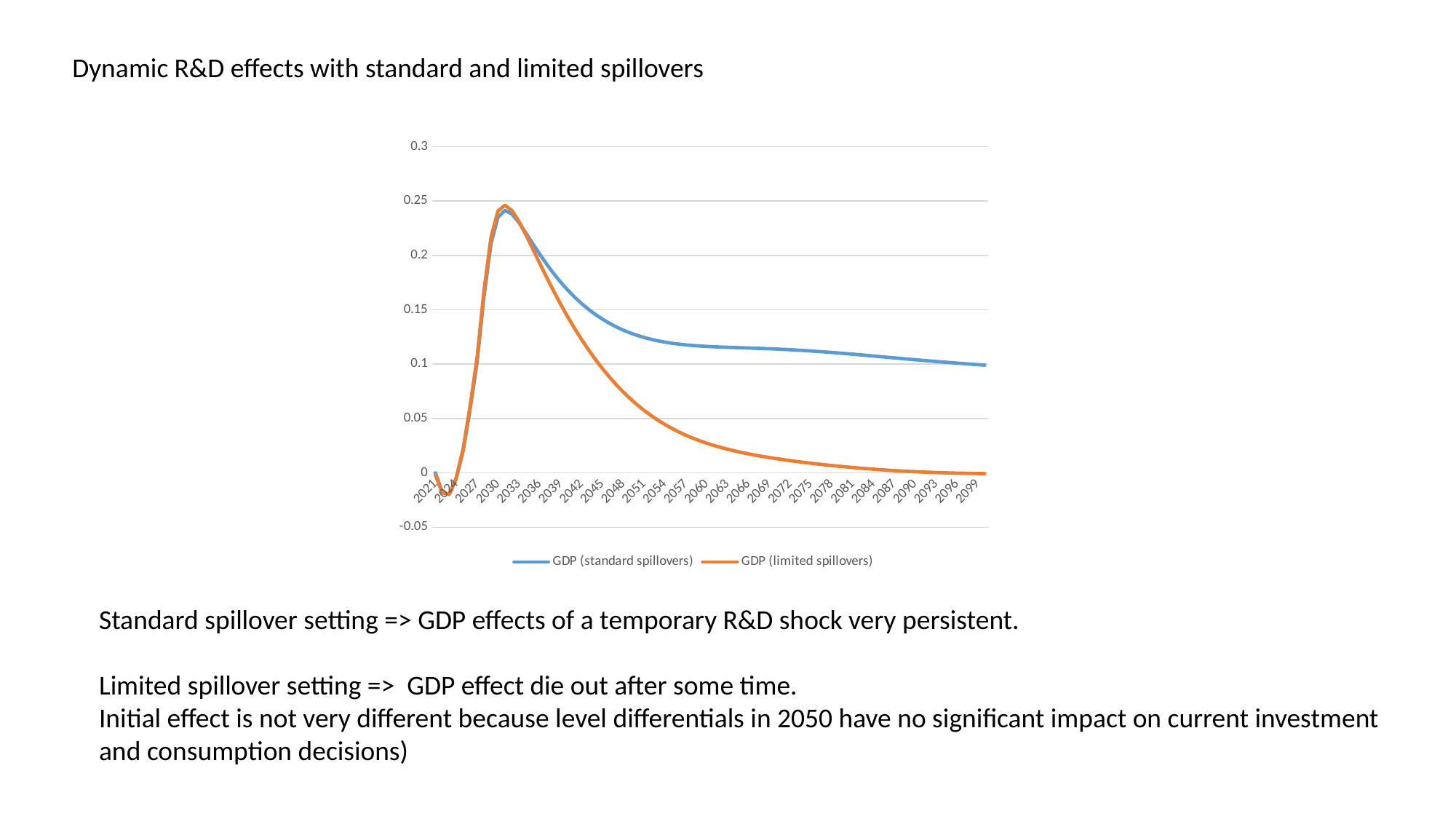
Is the peak value of GDP (limited spillovers) around 2031 greater or less than 0.2? greater How many year labels are shown on the x axis? 27 Does the GDP (limited spillovers) line rise or fall from 2033 to 2099? fall What are the two series named in the chart's legend? GDP (standard spillovers) and GDP (limited spillovers) Which series is higher at the end of the period in 2099? GDP (standard spillovers) Is the value for GDP (limited spillovers) in 2060 greater or less than 0.05? less What kind of chart is shown on the slide? line chart Is the value for GDP (limited spillovers) in 2051 greater or less than 0.05? greater What colour is the GDP (limited spillovers) line? orange How many series does the chart's legend list? 2 In 2042, which series has the higher value, GDP (standard spillovers) or GDP (limited spillovers)? GDP (standard spillovers)